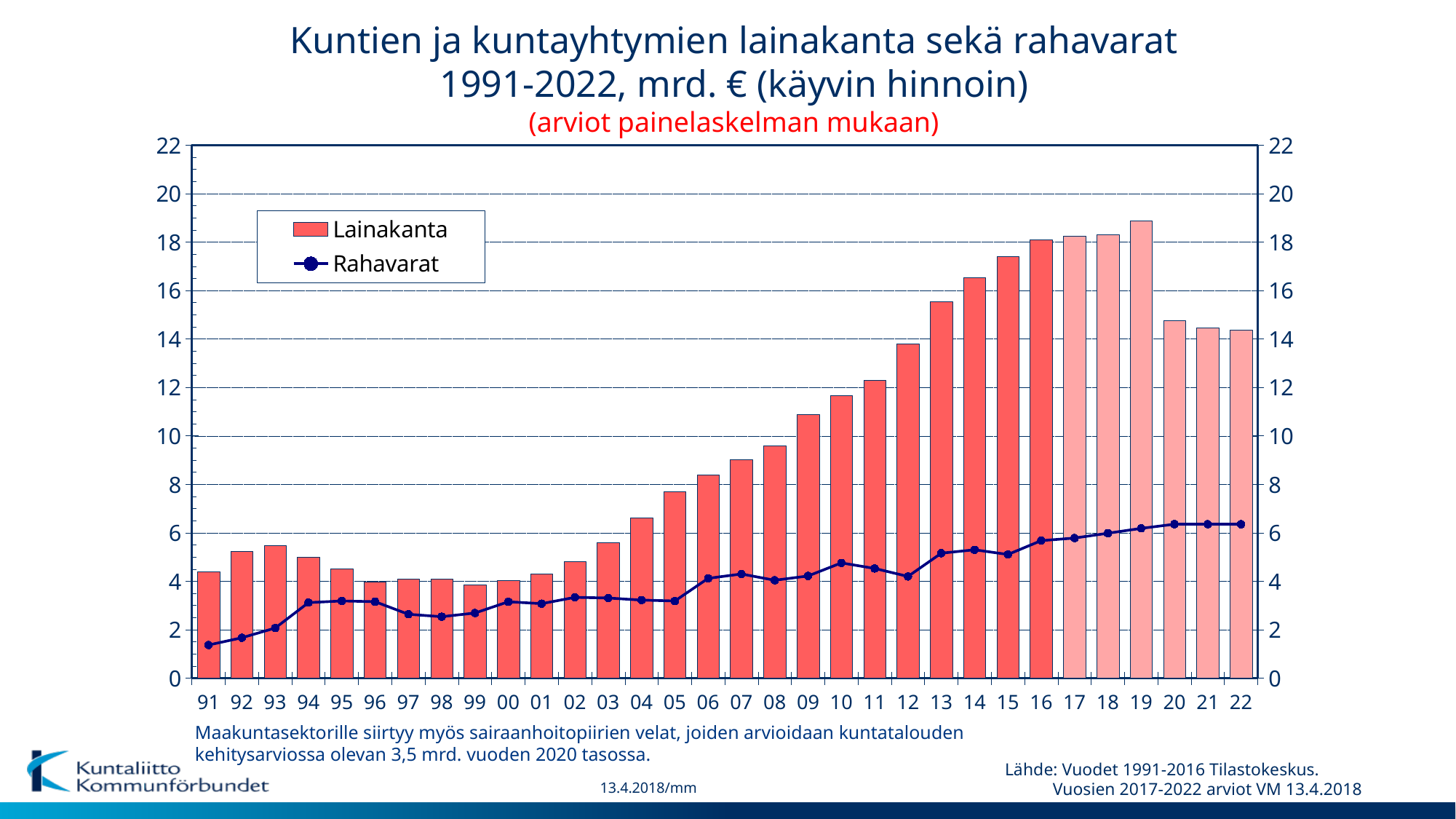
In which year is the Lainakanta bar highest? 19 Does the Lainakanta series rise or fall from 05 to 16? rise In which year is the Rahavarat value lowest? 91 Is the Rahavarat value for 12 greater or less than 6? less How many series does the legend list? 2 Is the Lainakanta value for 04 greater or less than 8? less Is the Lainakanta value for 19 greater or less than 18? greater What kind of chart is shown on the slide? A bar chart combined with a line chart What are the two series named in the legend? Lainakanta and Rahavarat Which is larger, the Lainakanta value for 19 or for 20? 19 How many years are shown on the x axis? 32 Does the Lainakanta series rise or fall from 19 to 22? fall